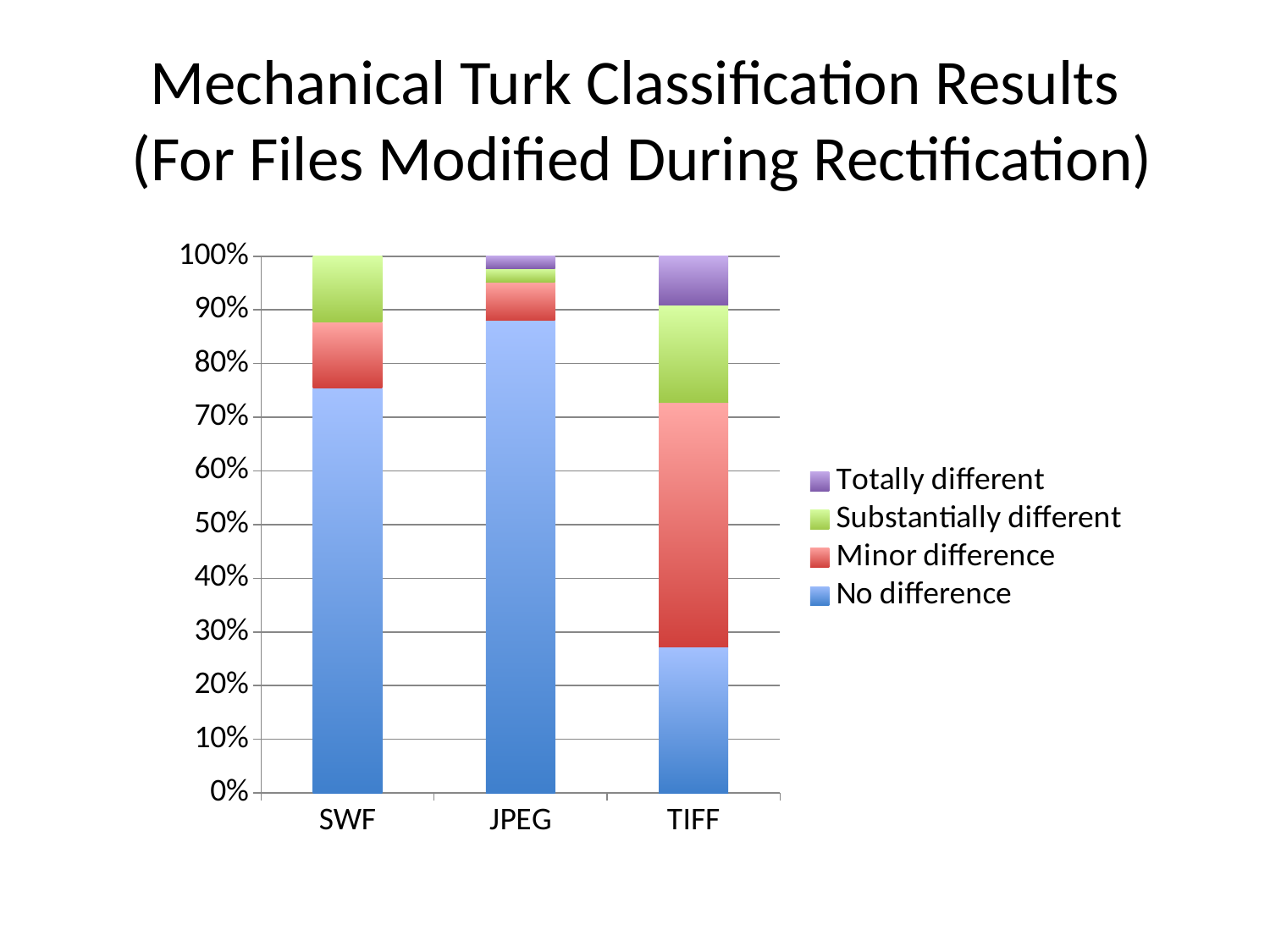
Which file format has the largest 'Totally different' segment? TIFF Is the 'No difference' share for SWF greater or less than 70%? greater How many series does the legend list? 4 What is the total height of the TIFF stacked bar? 100% What kind of chart is shown on the slide? Stacked bar chart Is the 'No difference' share for TIFF greater or less than 30%? less How many file format categories are shown on the x axis? 3 What is the title of the chart? Mechanical Turk Classification Results (For Files Modified During Rectification) Which file format has the lowest share of 'No difference'? TIFF Which file format has the highest share of 'No difference'? JPEG Which legend entry is shown in blue? No difference Which is larger, the 'No difference' share for JPEG or for TIFF? JPEG